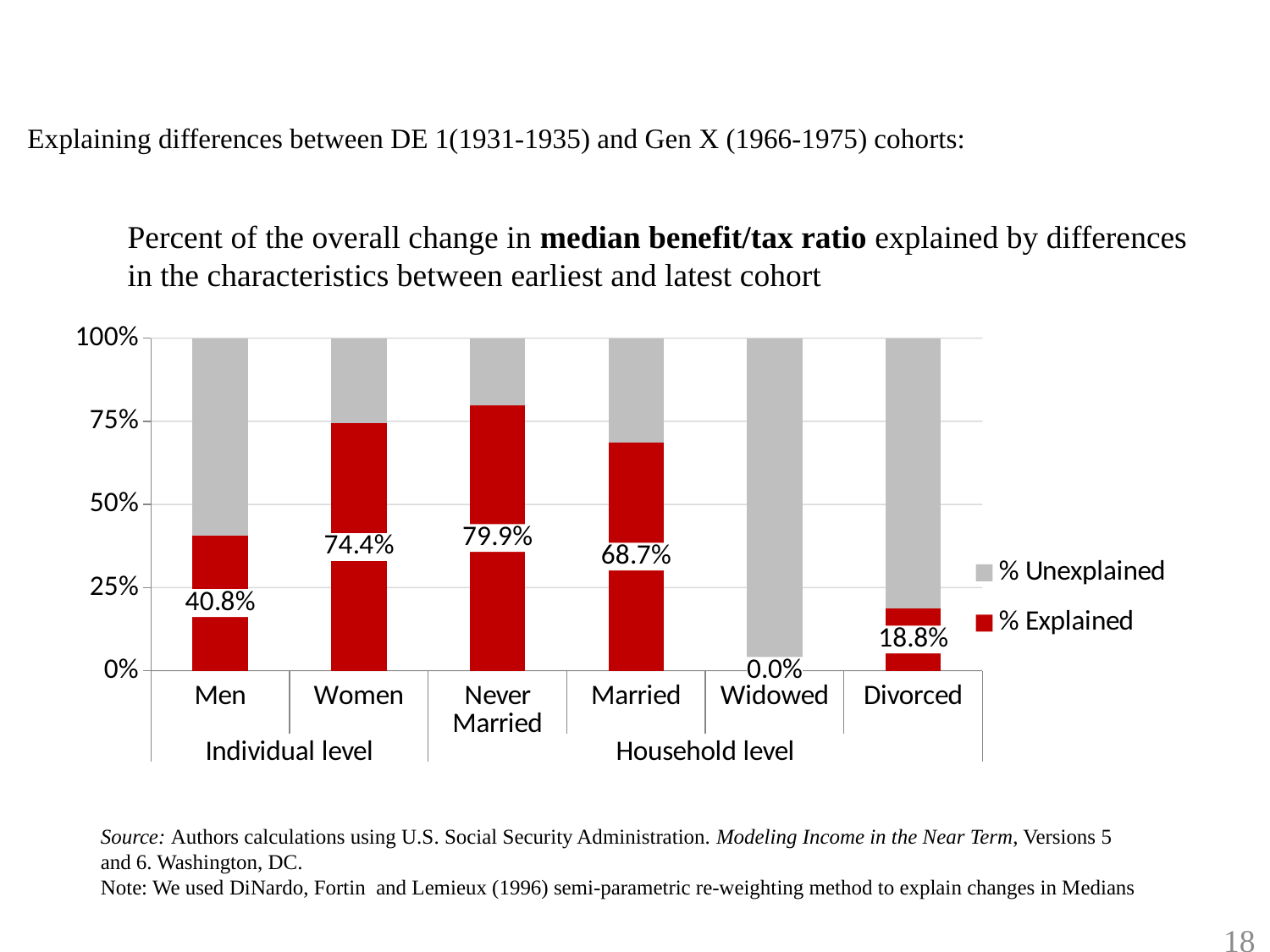
How many series does the legend list? 2 What kind of chart is shown on the slide? stacked bar chart What is the difference between the % Explained values for Women and Men? 33.6% What is the % Explained value for Divorced? 18.8% Which category has the lowest % Explained value? Widowed Which colour represents % Explained in the chart? red Is the % Unexplained portion for Men greater or less than 50%? greater What is the % Explained value for Men? 40.8% Which has a larger % Explained value, Married or Divorced? Married What is the % Explained value for Never Married? 79.9% Which category has the highest % Explained value? Never Married How many categories are shown on the x axis? 6